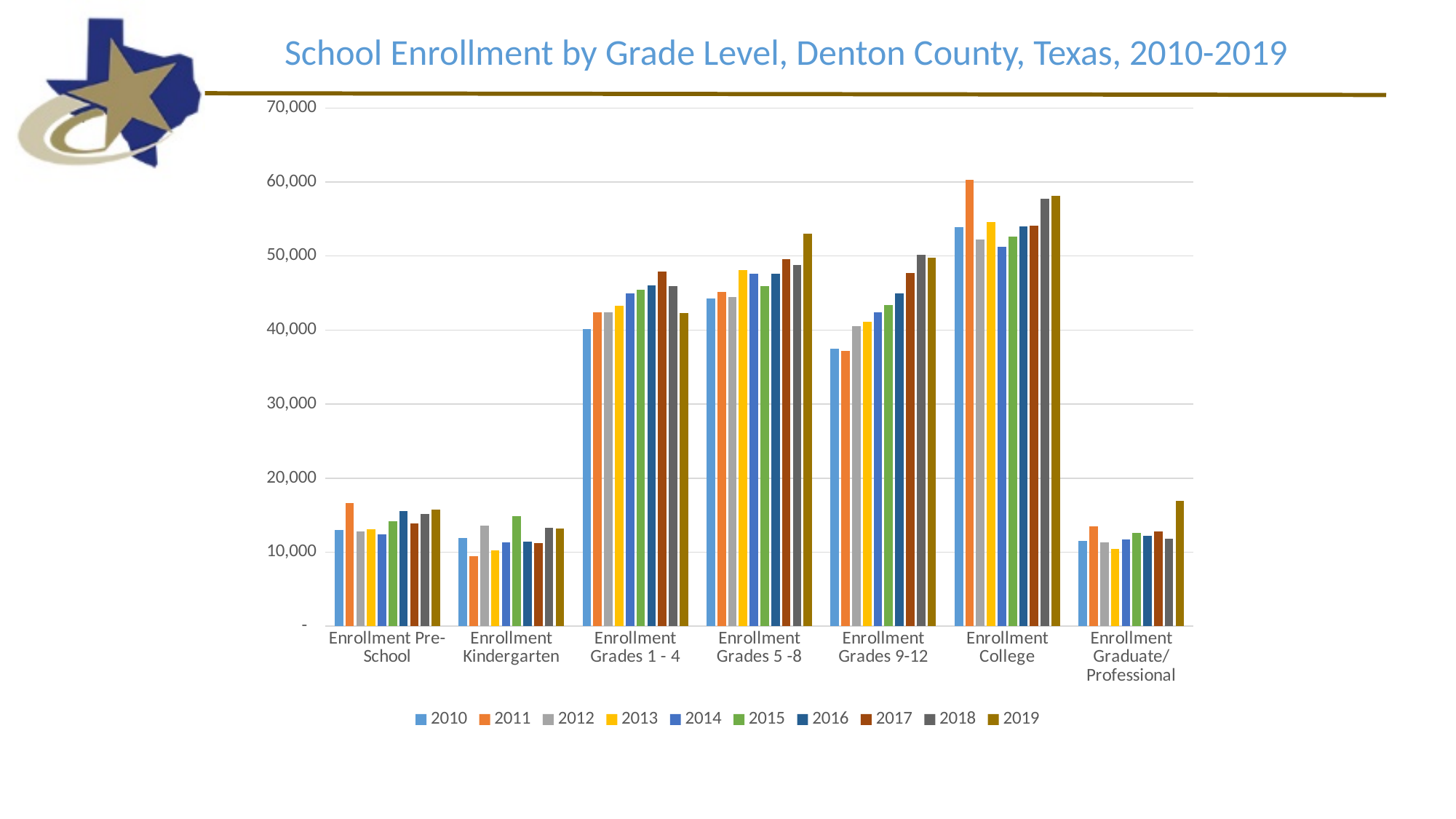
Is the 2010 value for Enrollment Grades 9-12 greater or less than 40,000? less For Enrollment College, which is larger: the 2011 value or the 2012 value? 2011 Does enrollment for Enrollment Grades 9-12 generally rise or fall from 2010 to 2019? rise Within Enrollment Grades 5 -8, which year has the highest enrollment? 2019 Is the 2019 value for Enrollment Graduate/Professional greater or less than 20,000? less Within Enrollment Grades 1 - 4, which year has the highest enrollment? 2017 Which category has the tallest bar on the chart? Enrollment College Within Enrollment Kindergarten, which year has the lowest enrollment? 2011 How many series (years) does the legend list? 10 Is the 2011 value for Enrollment College greater or less than 50,000? greater How many grade-level categories are shown along the x axis? 7 What type of chart is shown on the slide? bar chart